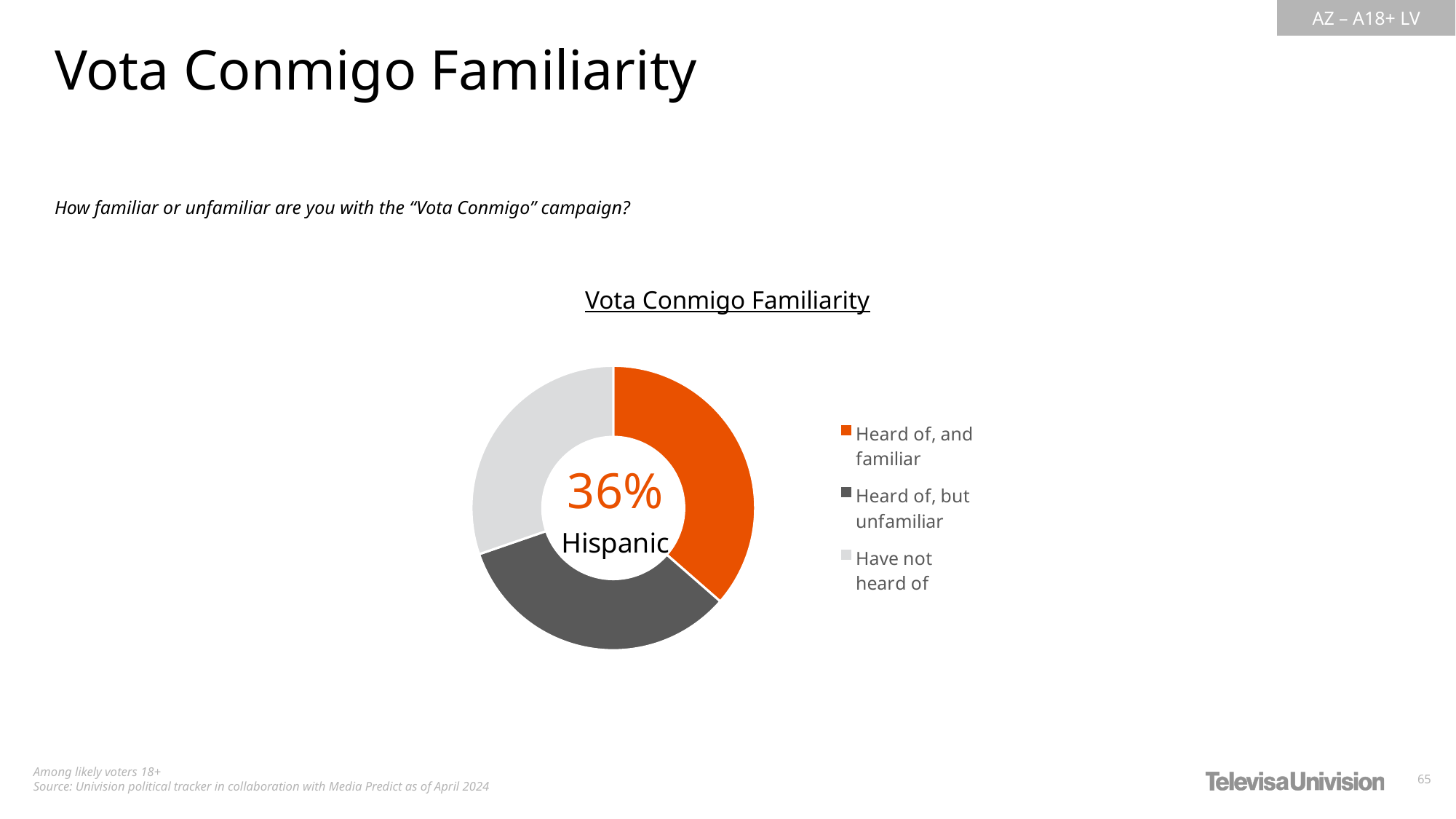
Is the 'Heard of, but unfamiliar' slice greater or less than 50% of the donut? less Which legend entry is shown in orange? Heard of, and familiar What share of Hispanic likely voters have heard of, and are familiar with, the Vota Conmigo campaign? 36% Is the 'Have not heard of' slice greater or less than 50% of the donut? less What percentage is printed in the centre of the donut chart? 36% How many categories does the Vota Conmigo Familiarity chart show? 3 What kind of chart is shown on the slide? pie chart (donut) How many entries does the legend of the Vota Conmigo Familiarity chart list? 3 Which group is labelled in the centre of the donut chart? Hispanic